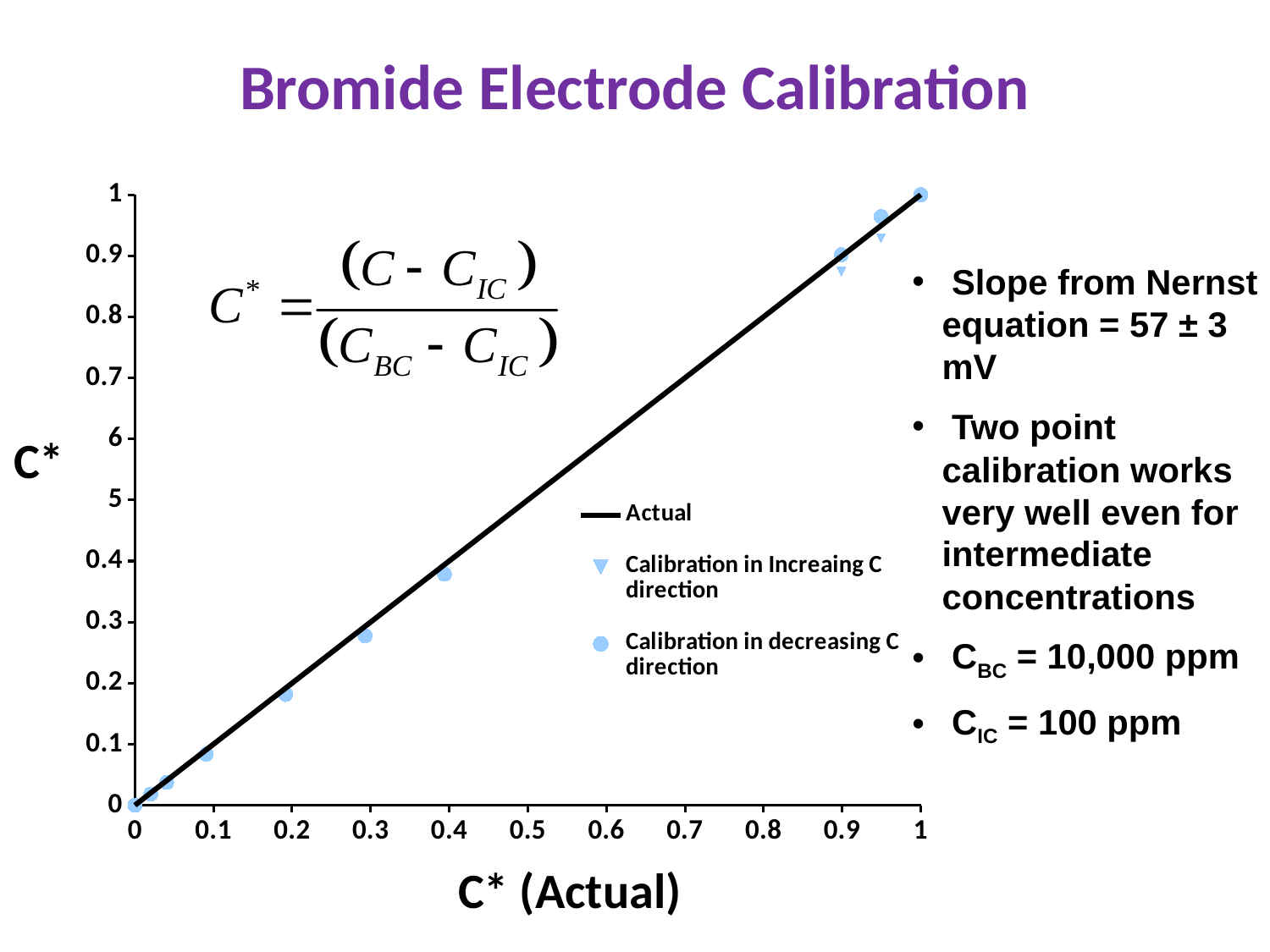
What is the label of the x axis? C* (Actual) Is the calibration value plotted near C* (Actual) = 0.9 greater or less than 0.8? greater Is the calibration value plotted near C* (Actual) = 0.2 greater or less than 0.3? less What is the highest value shown on the y axis of the chart? 1 How many series does the chart legend list? 3 Do the plotted values rise or fall as C* (Actual) increases along the x axis? Rise What kind of chart is shown on the slide? Scatter chart with a line What is the title of the chart? Bromide Electrode Calibration Is the calibration value plotted near C* (Actual) = 0.3 greater or less than 0.4? less